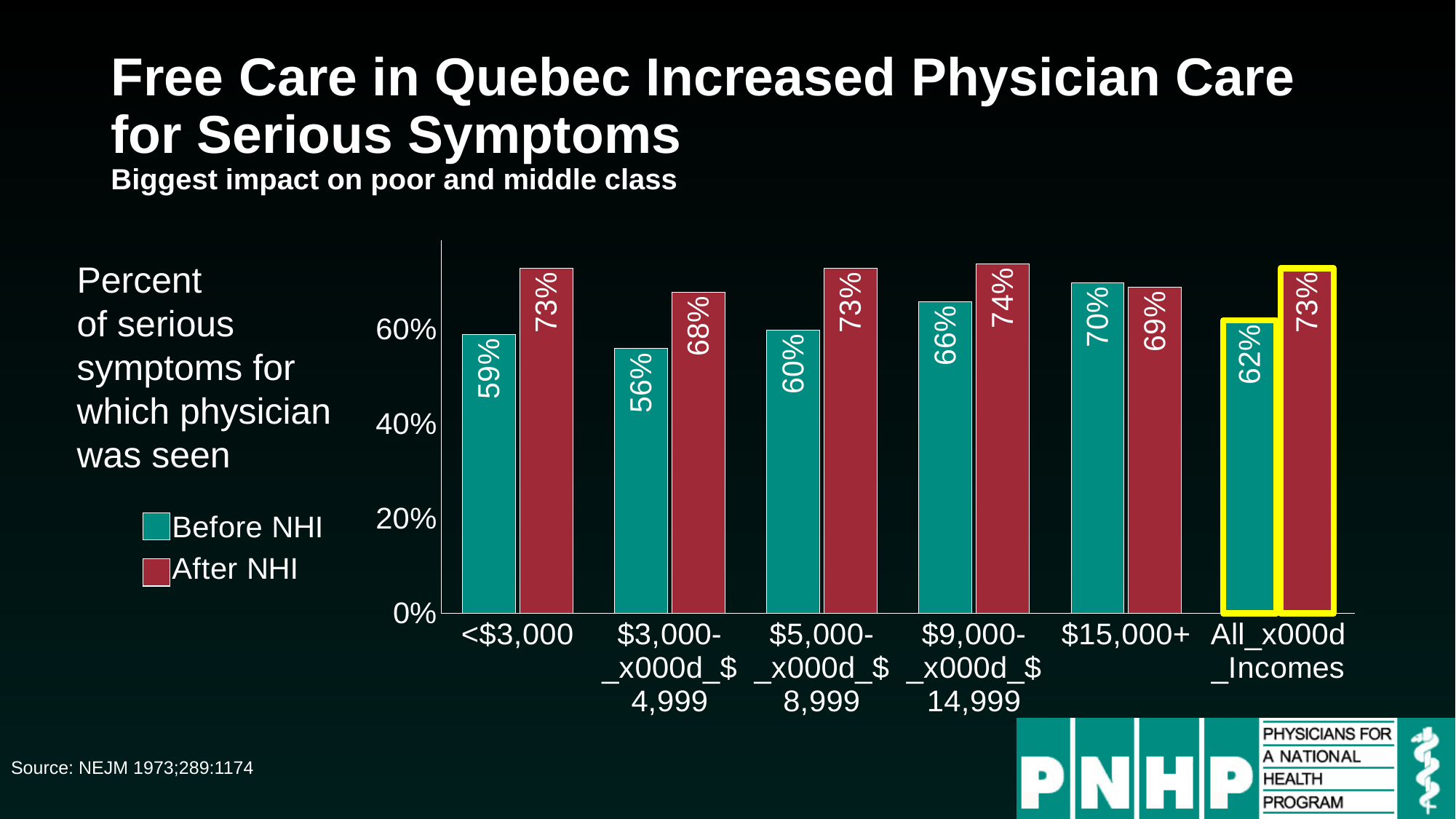
What is the difference between the After NHI and Before NHI values for the $3,000-$4,999 income group? 12% Which series is shown in red in the legend? After NHI For the $15,000+ income group, which is larger, the Before NHI value or the After NHI value? Before NHI What is the After NHI value for the $9,000-$14,999 income group? 74% Which income group has the lowest Before NHI value? $3,000-$4,999 How many series does the legend list? 2 What is the Before NHI value for All Incomes? 62% How many income groups are shown on the x axis? 6 What kind of chart is shown on the slide? Bar chart What is the After NHI value for the $3,000-$4,999 income group? 68% Which income group has the highest After NHI value? $9,000-$14,999 What is the Before NHI value for the <$3,000 income group? 59%